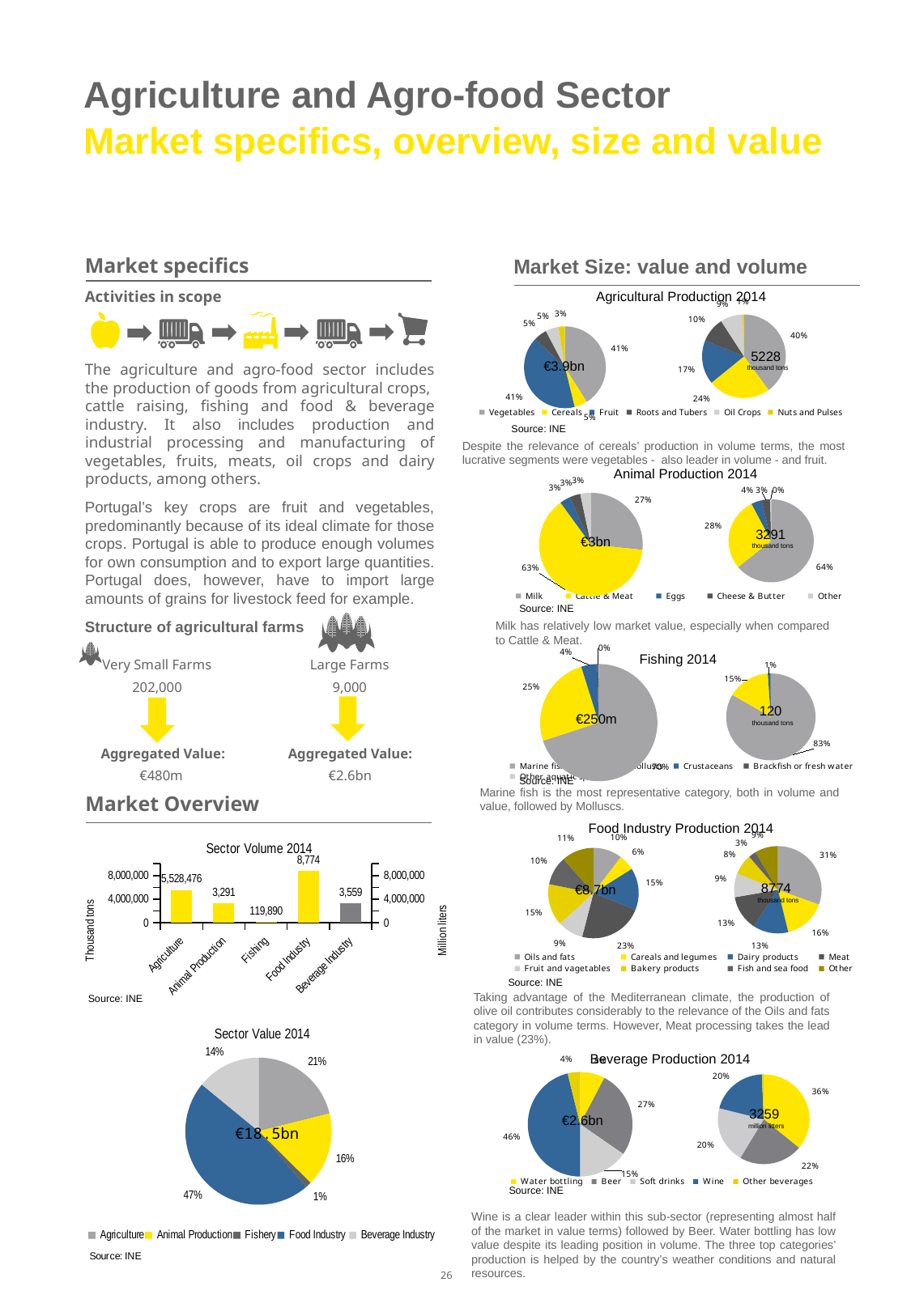
In the Sector Volume 2014 bar chart, what is the value for Agriculture? 5,528,476 In the Sector Value 2014 pie chart, which category has the smallest share? Fishery In the Sector Value 2014 pie chart, what share does Food Industry have? 47% In the Sector Value 2014 pie chart, what is the difference between the Food Industry share and the Agriculture share? 26% In the Sector Volume 2014 bar chart, what is the value for Food Industry? 8,774 How many categories are shown in the Sector Volume 2014 bar chart? 5 How many series does the legend of the Beverage Production 2014 charts list? 5 In the Agricultural Production 2014 charts, what total volume in thousand tons is shown in the centre of the volume pie? 5228 In the Fishing 2014 charts, what total value is shown in the centre of the value pie? €250m What kind of chart is the Sector Volume 2014 chart? Bar chart In the Sector Volume 2014 bar chart, what is the value for Fishing? 119,890 What total value is shown in the centre of the Sector Value 2014 pie chart? €18.5bn